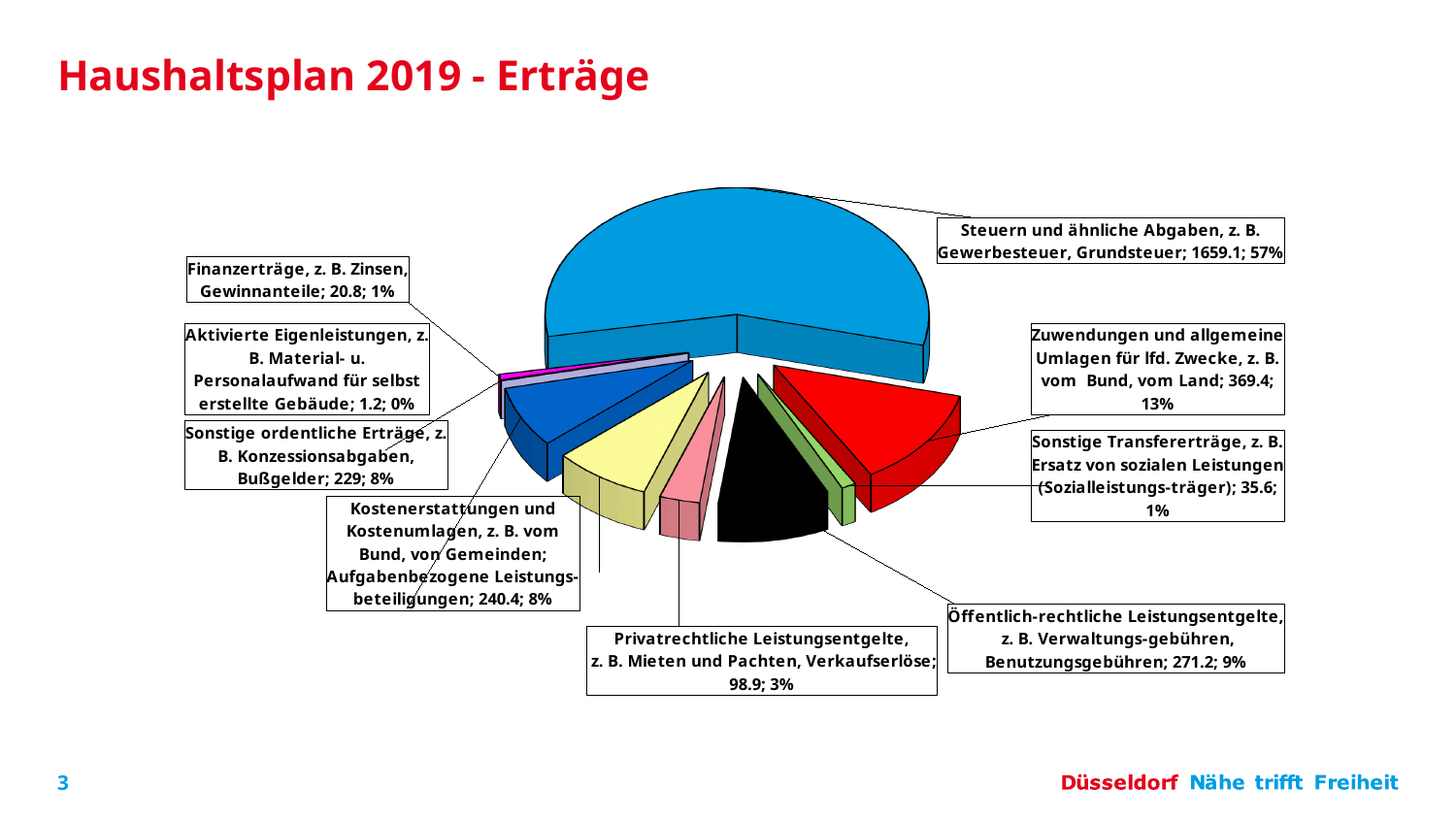
What is the title of the slide containing the pie chart? Haushaltsplan 2019 - Erträge What is the value shown for Steuern und ähnliche Abgaben? 1659.1 Which category has the largest slice of the pie? Steuern und ähnliche Abgaben Which is larger: the value for Kostenerstattungen und Kostenumlagen or the value for Sonstige ordentliche Erträge? Kostenerstattungen und Kostenumlagen What percentage is shown for Öffentlich-rechtliche Leistungsentgelte? 9% Which category has the smallest value in the pie chart? Aktivierte Eigenleistungen What is the value shown for Zuwendungen und allgemeine Umlagen für lfd. Zwecke? 369.4 What is the value shown for Privatrechtliche Leistungsentgelte? 98.9 How many categories are shown in the pie chart? 9 What share of the pie does Steuern und ähnliche Abgaben represent? 57% What kind of chart is shown on the slide? pie chart What is the difference between the values for Zuwendungen und allgemeine Umlagen (369.4) and Öffentlich-rechtliche Leistungsentgelte (271.2)? 98.2